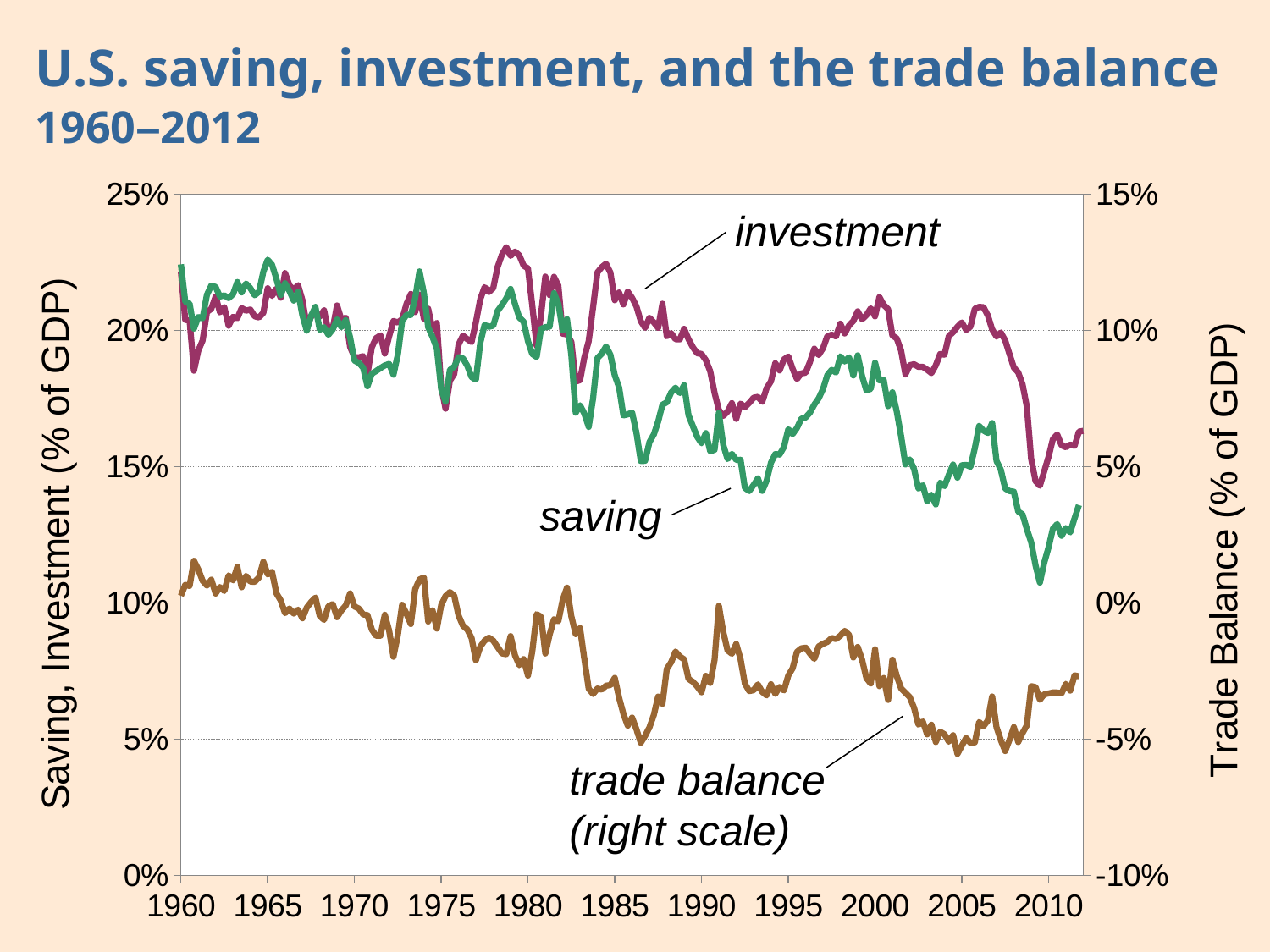
Is the trade balance in 2005 greater or less than 0%? less Does the saving series generally rise or fall from 1960 to 2012? fall Around 1990, which is larger, investment or saving? investment Which series is plotted against the right-hand scale? trade balance Does the trade balance series generally rise or fall from 1960 to 2012? fall What is the title of the chart? U.S. saving, investment, and the trade balance 1960–2012 Around 2005, which is larger, investment or saving? investment Is the value for saving around 2010 greater or less than 15%? less How many data series are plotted on the chart? 3 Is the trade balance in 1965 greater or less than 0%? greater What kind of chart is shown on the slide? line chart